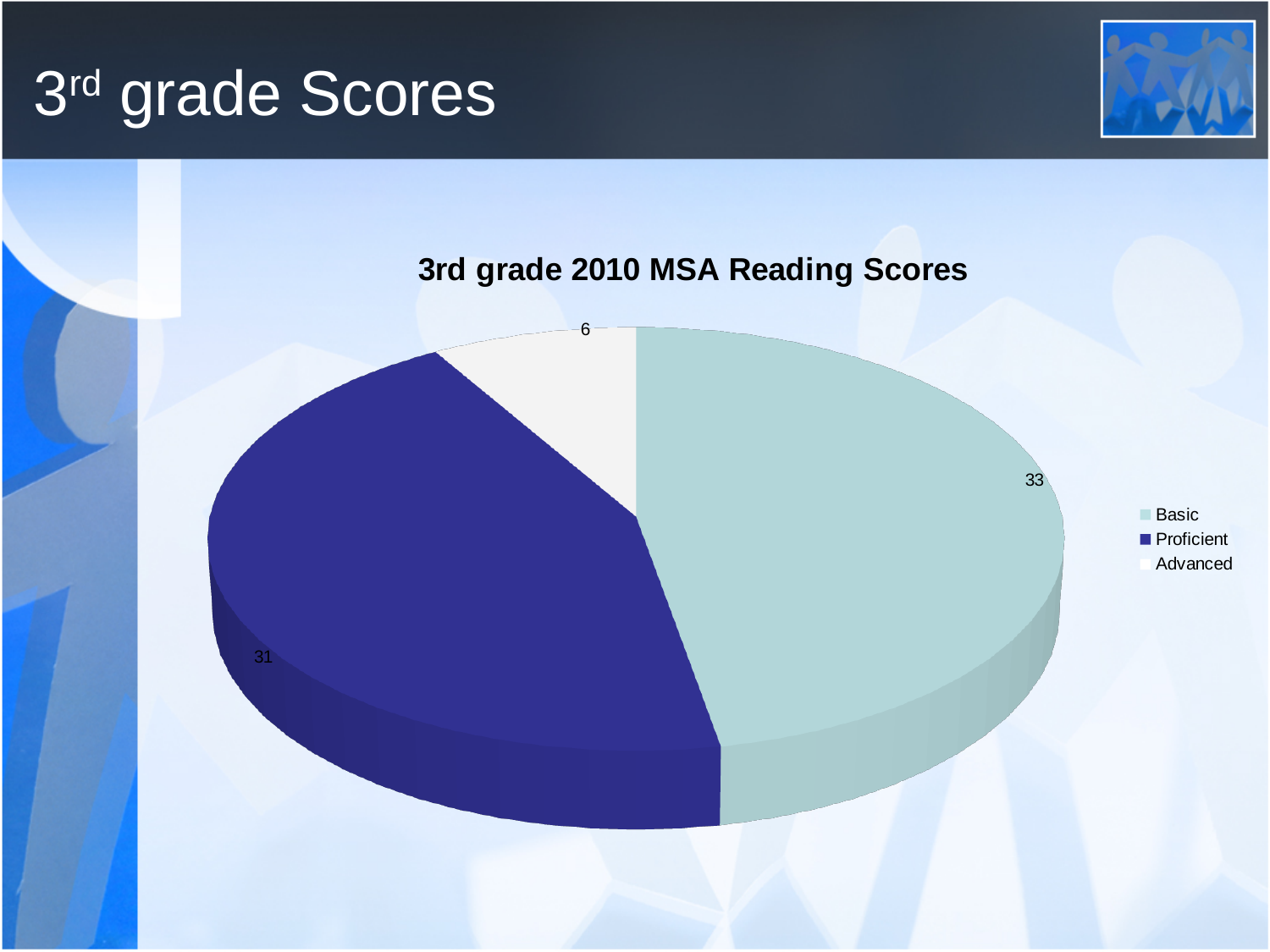
Which is larger, the value for Proficient or the value for Advanced? Proficient Which category has the smallest slice? Advanced Which category has the largest slice? Basic What is the total of all slices in the pie? 70 What is the value for Proficient? 31 What is the title of the chart? 3rd grade 2010 MSA Reading Scores What type of chart is shown on the slide? pie chart What is the difference between the Basic and Proficient values? 2 How many categories does the legend list? 3 What is the value for Basic? 33 What is the value for Advanced? 6 What is the difference between the Proficient and Advanced values? 25